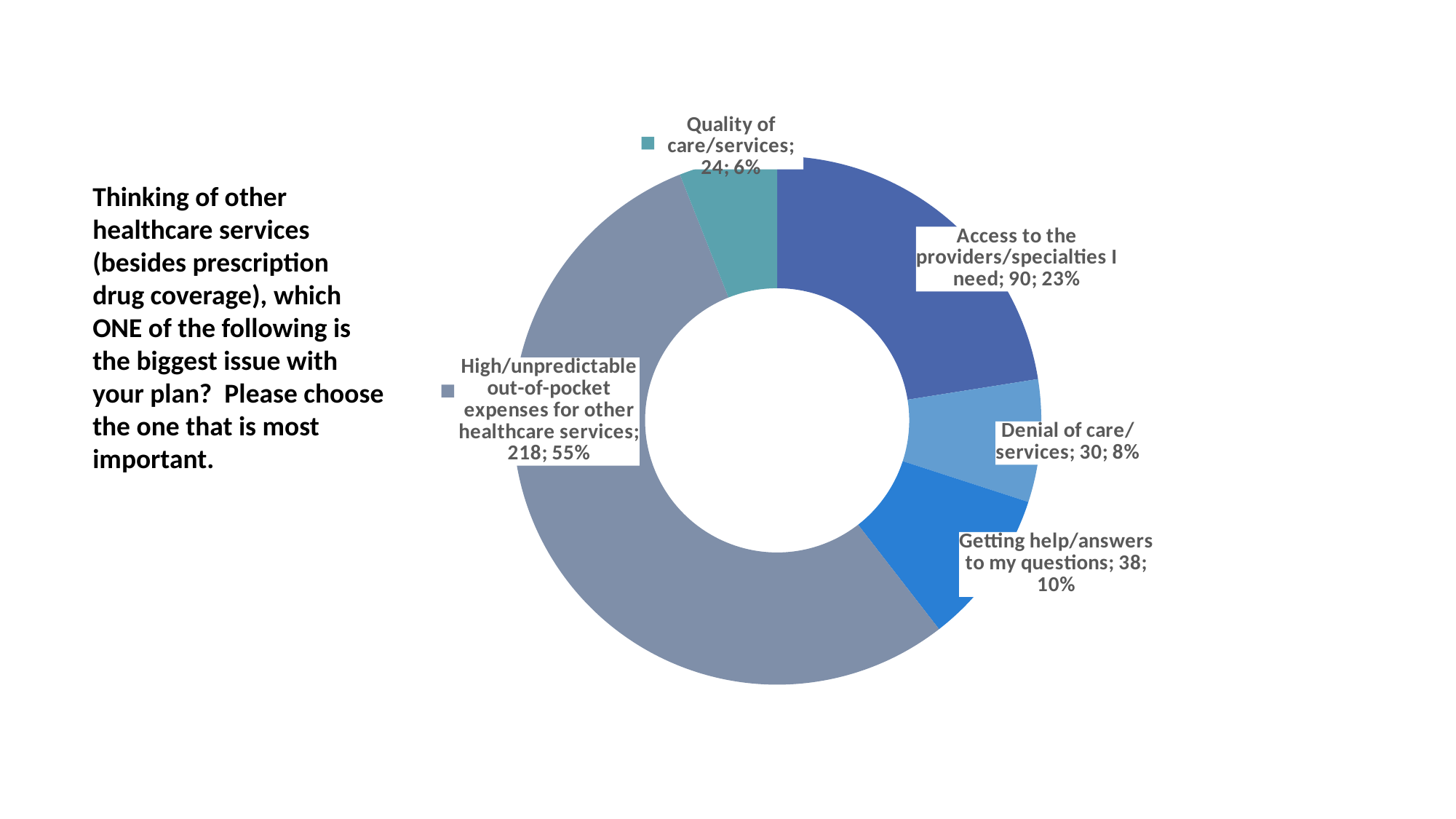
How many categories does the chart show? 5 What kind of chart is shown on the slide? Doughnut (pie) chart What is the count for 'Denial of care/services'? 30 Which has a larger count: 'Getting help/answers to my questions' or 'Quality of care/services'? Getting help/answers to my questions What percentage share does 'Getting help/answers to my questions' have? 10% What is the count for 'High/unpredictable out-of-pocket expenses for other healthcare services'? 218 What is the count for 'Quality of care/services'? 24 What percentage share does 'Access to the providers/specialties I need' have? 23% Which category has the largest share? High/unpredictable out-of-pocket expenses for other healthcare services Which category has the smallest share? Quality of care/services What is the difference in count between 'Access to the providers/specialties I need' and 'Denial of care/services'? 60 What is the total count across all categories? 400